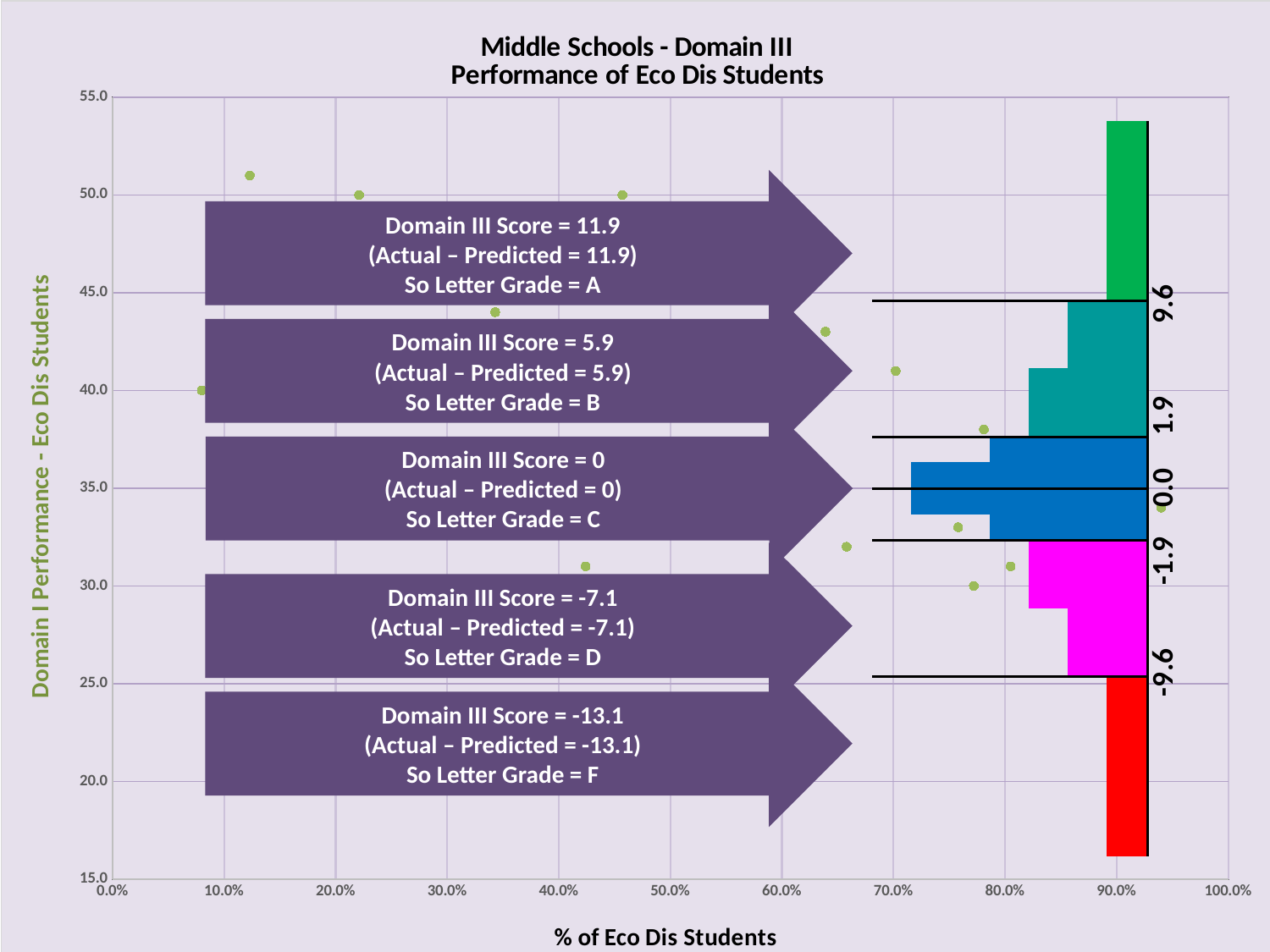
What is the label of the x axis? % of Eco Dis Students What is the title of the chart? Middle Schools - Domain III Performance of Eco Dis Students What kind of chart is shown on the slide? scatter chart What Domain III Score corresponds to Letter Grade F? -13.1 What letter grade corresponds to a Domain III Score of 11.9? A What Domain III Score corresponds to Letter Grade D? -7.1 What letter grade corresponds to a Domain III Score of 0? C Which letter grade has the highest Domain III Score shown? A Which letter grade has the lowest Domain III Score shown? F What Domain III Score corresponds to Letter Grade B? 5.9 How many letter-grade arrows are shown on the chart? 5 What is the difference between the Domain III Score for grade A (11.9) and grade B (5.9)? 6.0